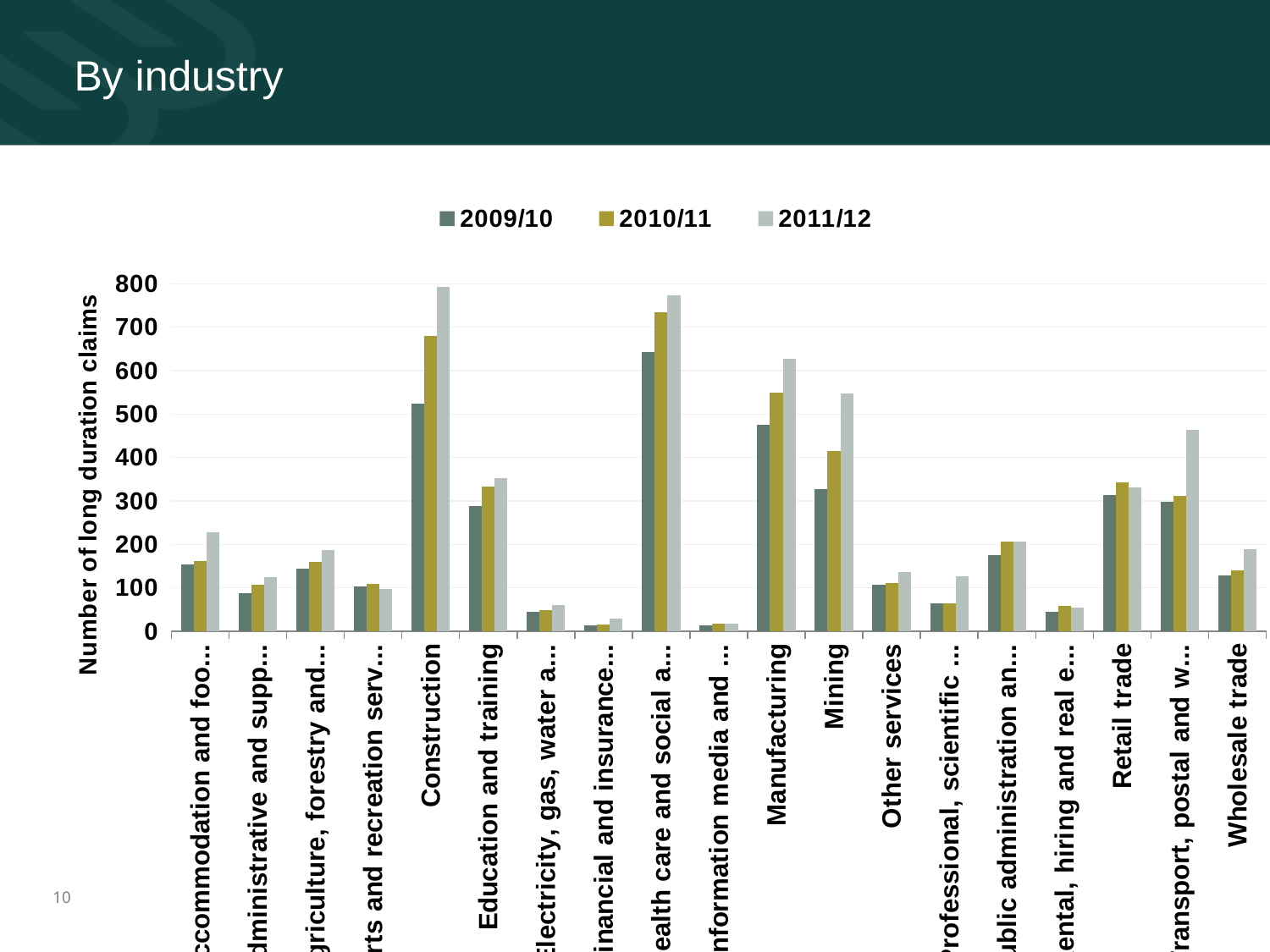
How many industry categories are plotted along the x axis? 19 How many series does the legend list? 3 Which is larger for 2011/12: Manufacturing or Mining? Manufacturing What is the title of the vertical axis? Number of long duration claims Which is larger for 2010/11: Retail trade or Wholesale trade? Retail trade What kind of chart is shown on the slide? bar chart Is the 2011/12 value for Construction greater or less than 700? greater Do the values for Mining rise or fall from 2009/10 to 2011/12? rise Is the 2011/12 value for Other services greater or less than 200? less Is the 2010/11 value for Manufacturing greater or less than 500? greater Which years are listed in the legend? 2009/10, 2010/11, 2011/12